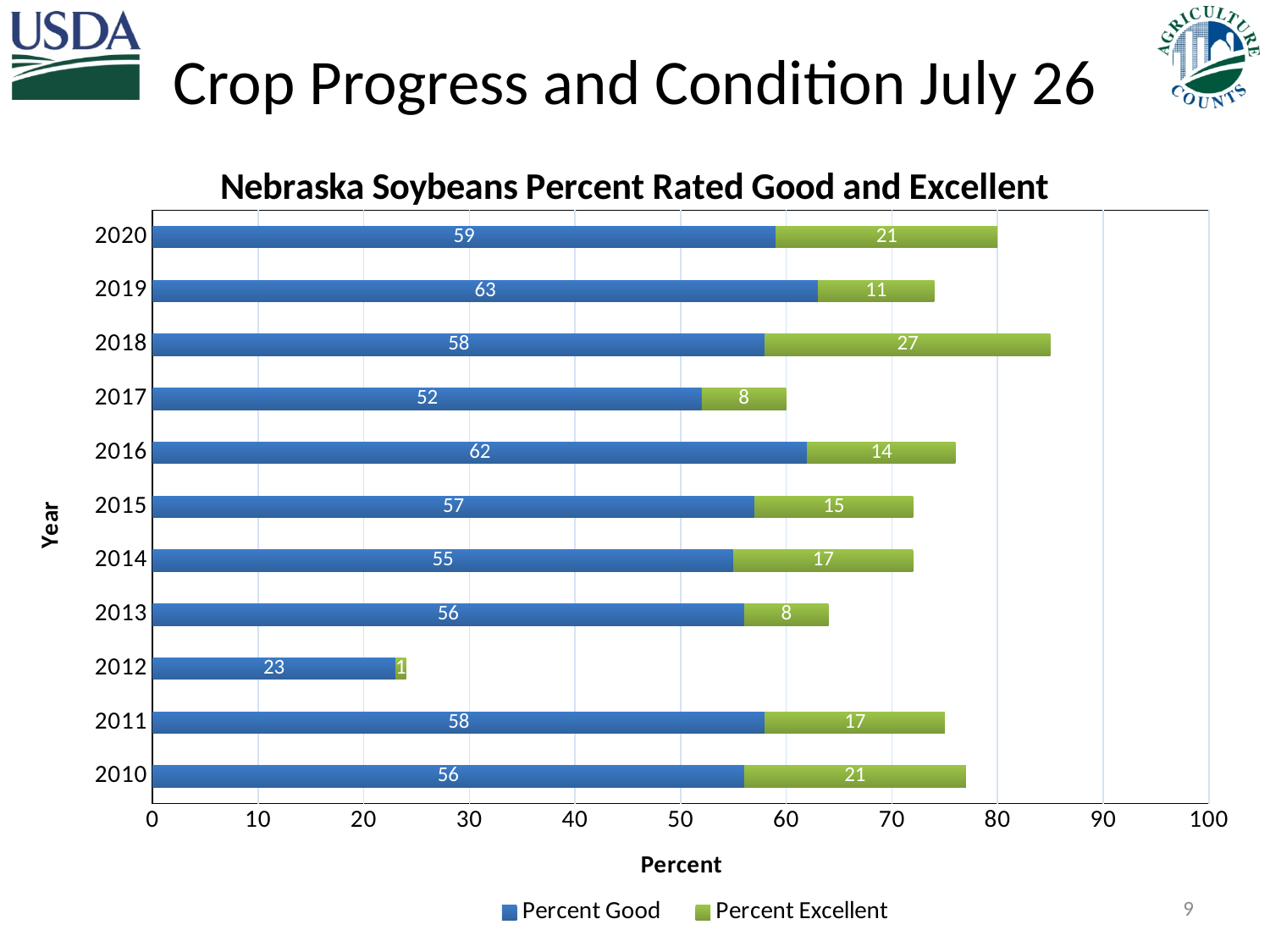
What is the Percent Excellent value for 2018? 27 How many series does the legend list? 2 Which year has the highest Percent Excellent value? 2018 What is the title of the chart? Nebraska Soybeans Percent Rated Good and Excellent What is the total of the stacked bar for 2012? 24 Which year has the lowest Percent Good value? 2012 What is the difference between the Percent Good values for 2019 and 2017? 11 What is the total of the stacked bar for 2018? 85 What kind of chart is shown on the slide? Stacked bar chart How many years are shown on the chart? 11 What is the Percent Good value for 2020? 59 Which is larger, the Percent Excellent value for 2010 or for 2019? 2010